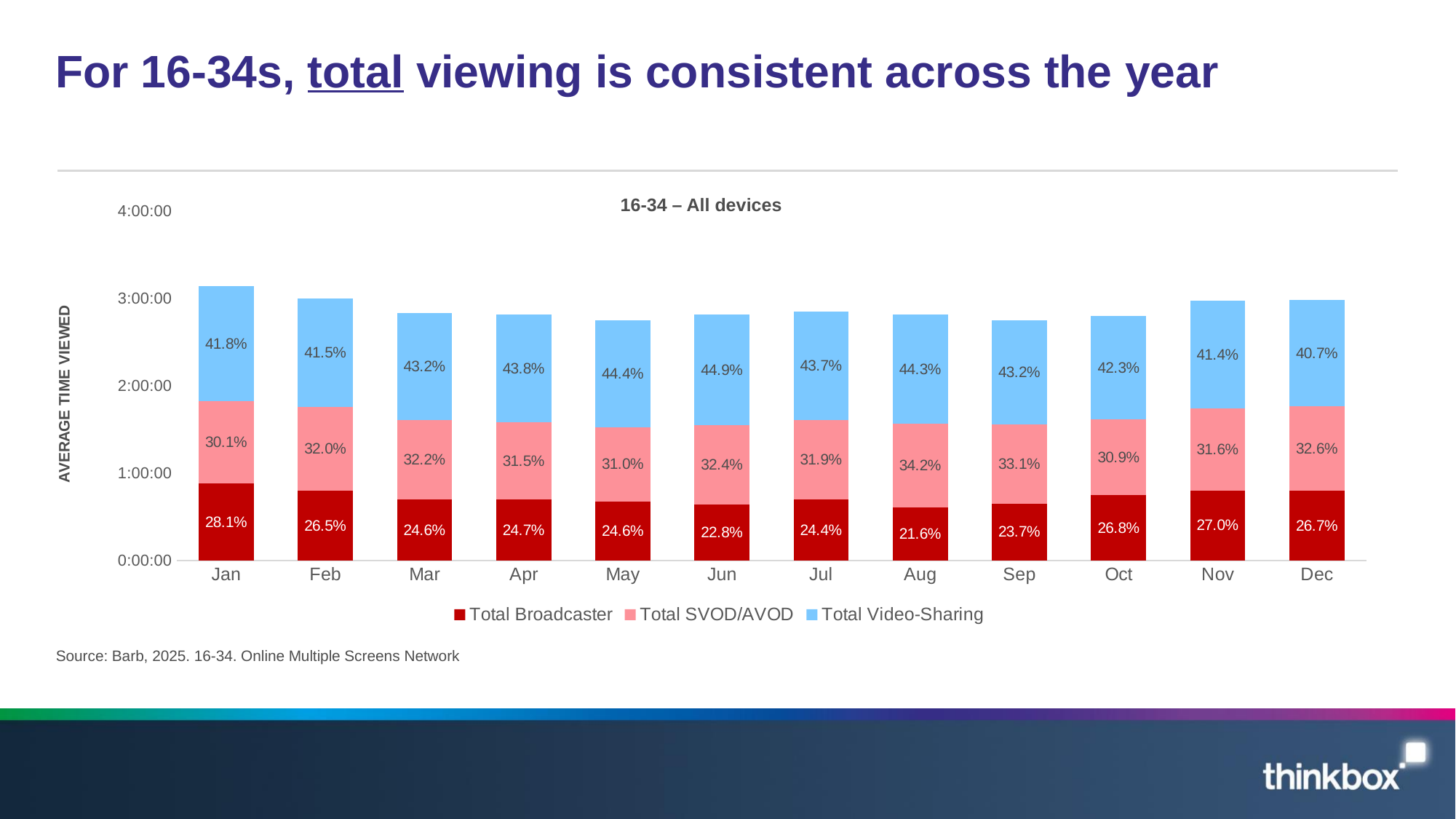
Which is larger, the Total SVOD/AVOD percentage label for Feb or for Oct? Feb Which month has the lowest Total Broadcaster percentage label? Aug What percentage label is shown for Total Broadcaster in Jan? 28.1% How many series does the legend list? 3 What percentage label is shown for Total Video-Sharing in Jun? 44.9% How many months are shown on the x axis? 12 Is the total height of the Sep bar greater or less than 3:00:00? less What type of chart is shown on the slide? Stacked bar chart What percentage label is shown for Total SVOD/AVOD in Aug? 34.2% Is the total height of the Jan bar greater or less than 3:00:00? greater Which month has the highest Total Video-Sharing percentage label? Jun What is the difference between the Total Broadcaster percentage labels for Jan and Aug? 6.5%